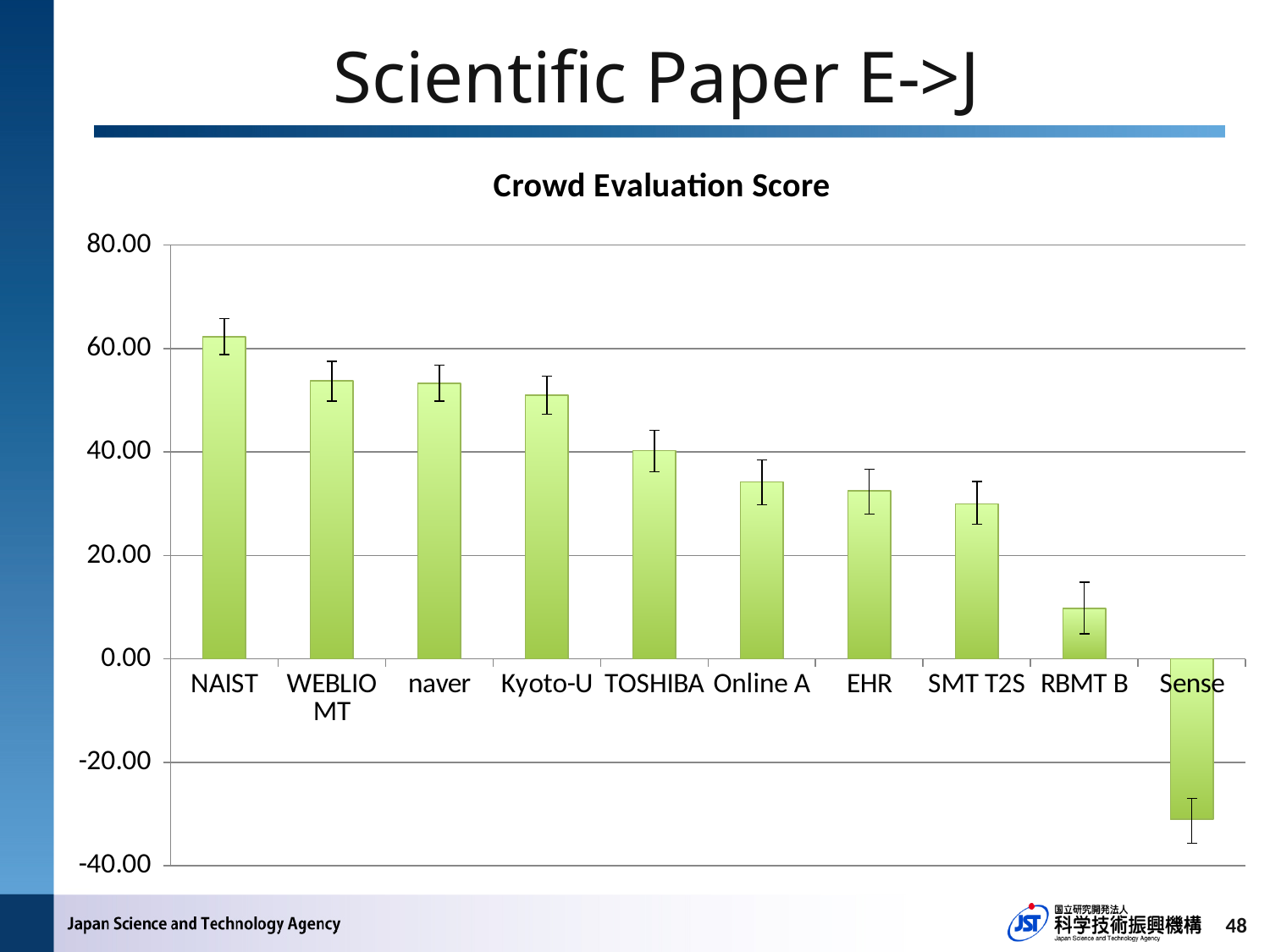
Is the value for Sense greater or less than -20.00? less Is the value for RBMT B greater or less than 20.00? less How many categories (systems) are plotted on the x axis? 10 Which category has the lowest Crowd Evaluation Score? Sense Is the value for TOSHIBA greater or less than 20.00? greater What is the title of the chart? Crowd Evaluation Score What kind of chart is shown on the slide? bar chart Which category has the highest Crowd Evaluation Score? NAIST How many categories have a negative Crowd Evaluation Score? 1 Do the values generally rise or fall moving from left to right along the x axis? fall Which has a larger Crowd Evaluation Score, NAIST or TOSHIBA? NAIST